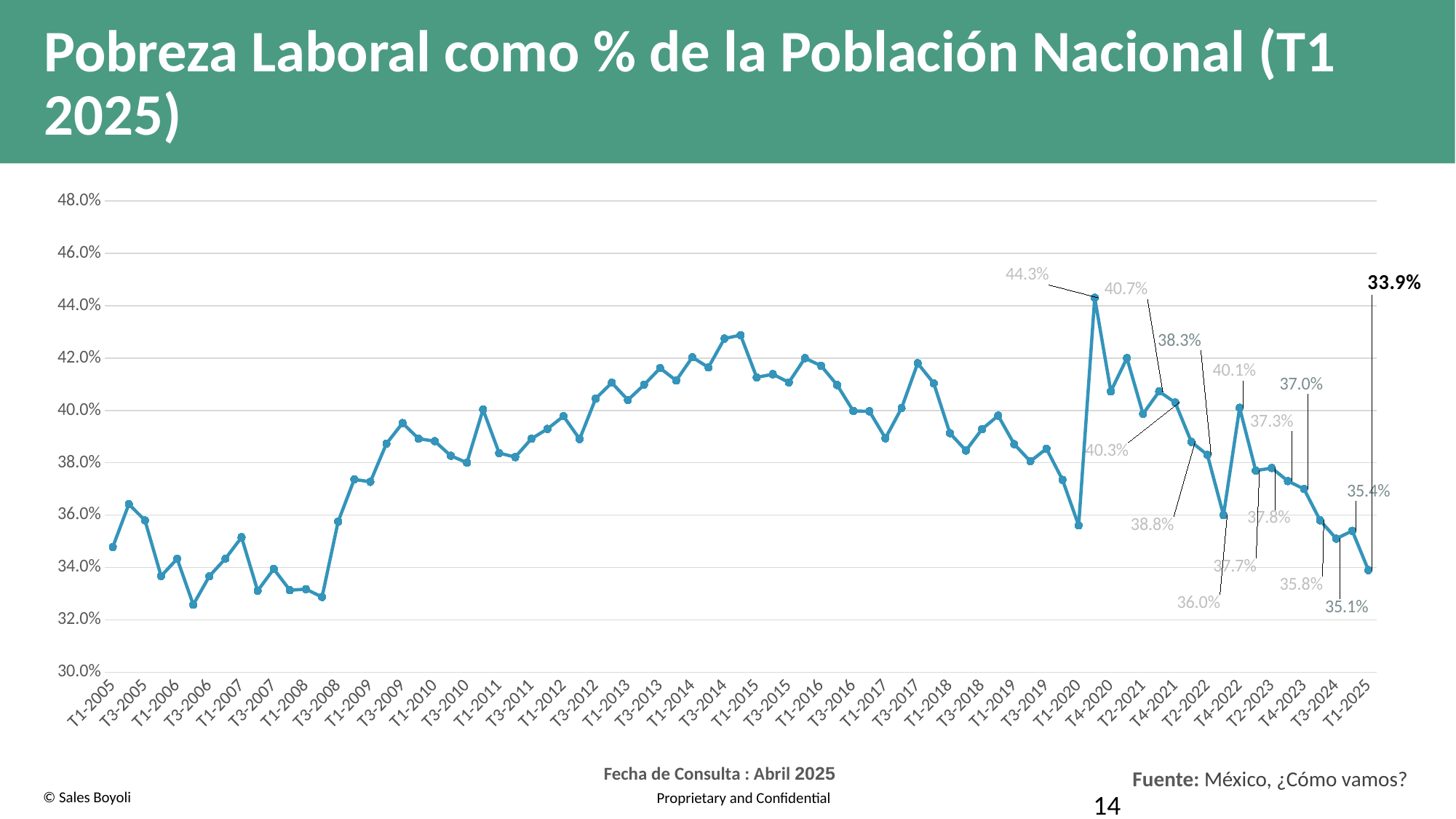
What is the difference between the labelled value 35.4% and the final value 33.9%? 1.5 percentage points What is the difference between the highest labelled value (44.3%) and the T1-2025 value (33.9%)? 10.4 percentage points Is the value for T3-2014 greater or less than 42.0%? greater What is the value at the highest point of the line (the spike in 2020)? 44.3% What is the title of the chart on the slide? Pobreza Laboral como % de la Población Nacional (T1 2025) What kind of chart is shown on the slide? line chart Is the value for T1-2005 greater or less than 36.0%? less Does the line rise or fall from the 2020 spike to T1-2025? fall What are the lowest and highest values shown on the vertical axis? 30.0% and 48.0% What is the value for T1-2025 on the chart? 33.9% Which is larger, the value at the 2020 spike (44.3%) or the value at T1-2025 (33.9%)? 44.3% at the 2020 spike